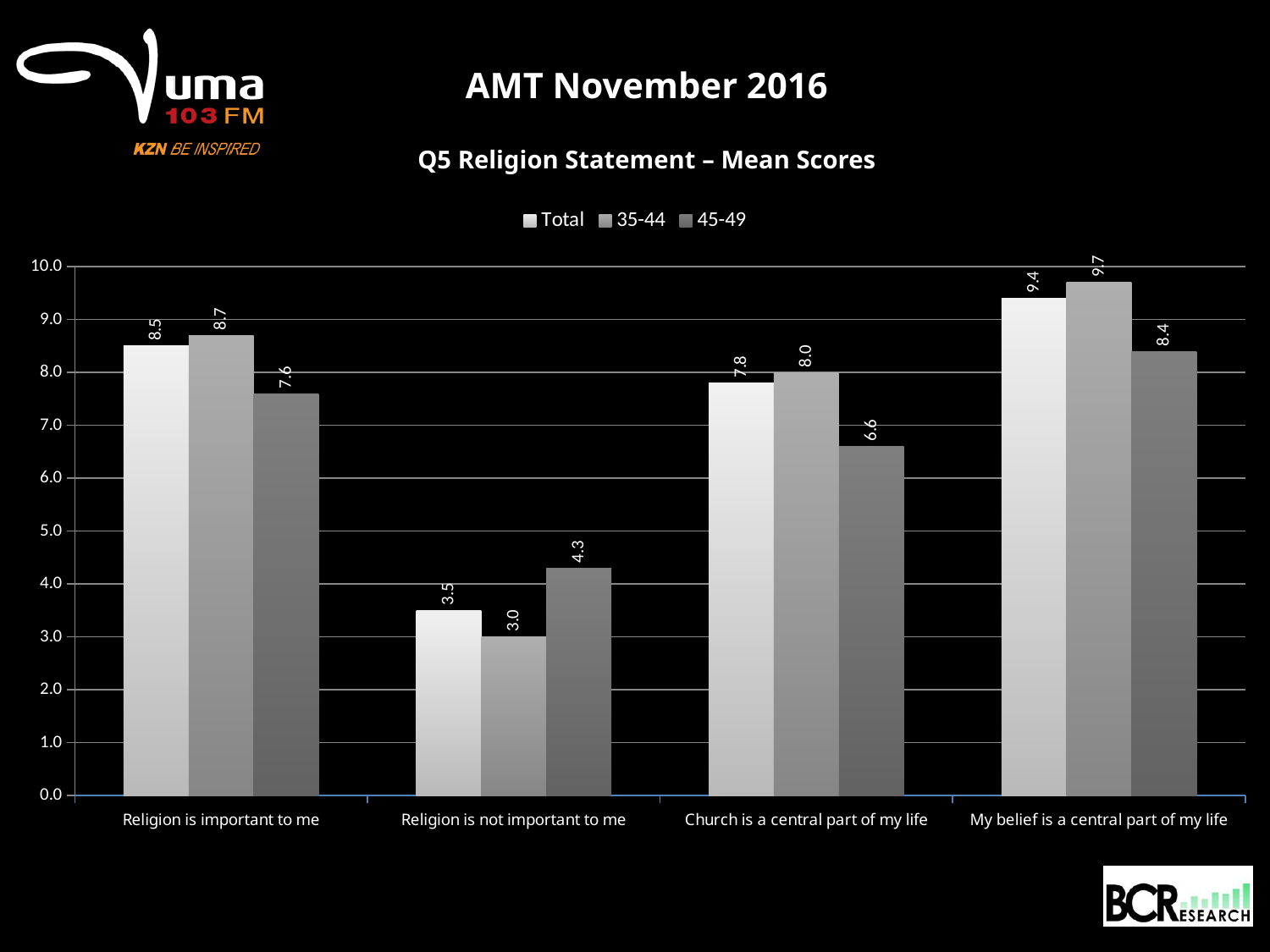
How many series does the legend list? 3 For "Religion is not important to me", which series has the larger mean score: Total or 45-49? 45-49 What is the Total mean score for "Religion is important to me"? 8.5 What kind of chart is shown on the slide? Bar chart What is the 35-44 mean score for "Religion is not important to me"? 3.0 Which statement has the highest Total mean score? My belief is a central part of my life Which statement has the lowest 35-44 mean score? Religion is not important to me What is the 45-49 mean score for "Church is a central part of my life"? 6.6 How many statements are shown on the x axis? 4 What is the difference between the 35-44 and 45-49 mean scores for "My belief is a central part of my life"? 1.3 What is the title of the chart? Q5 Religion Statement – Mean Scores Is the 45-49 mean score for "Religion is important to me" greater or less than 7.0? greater